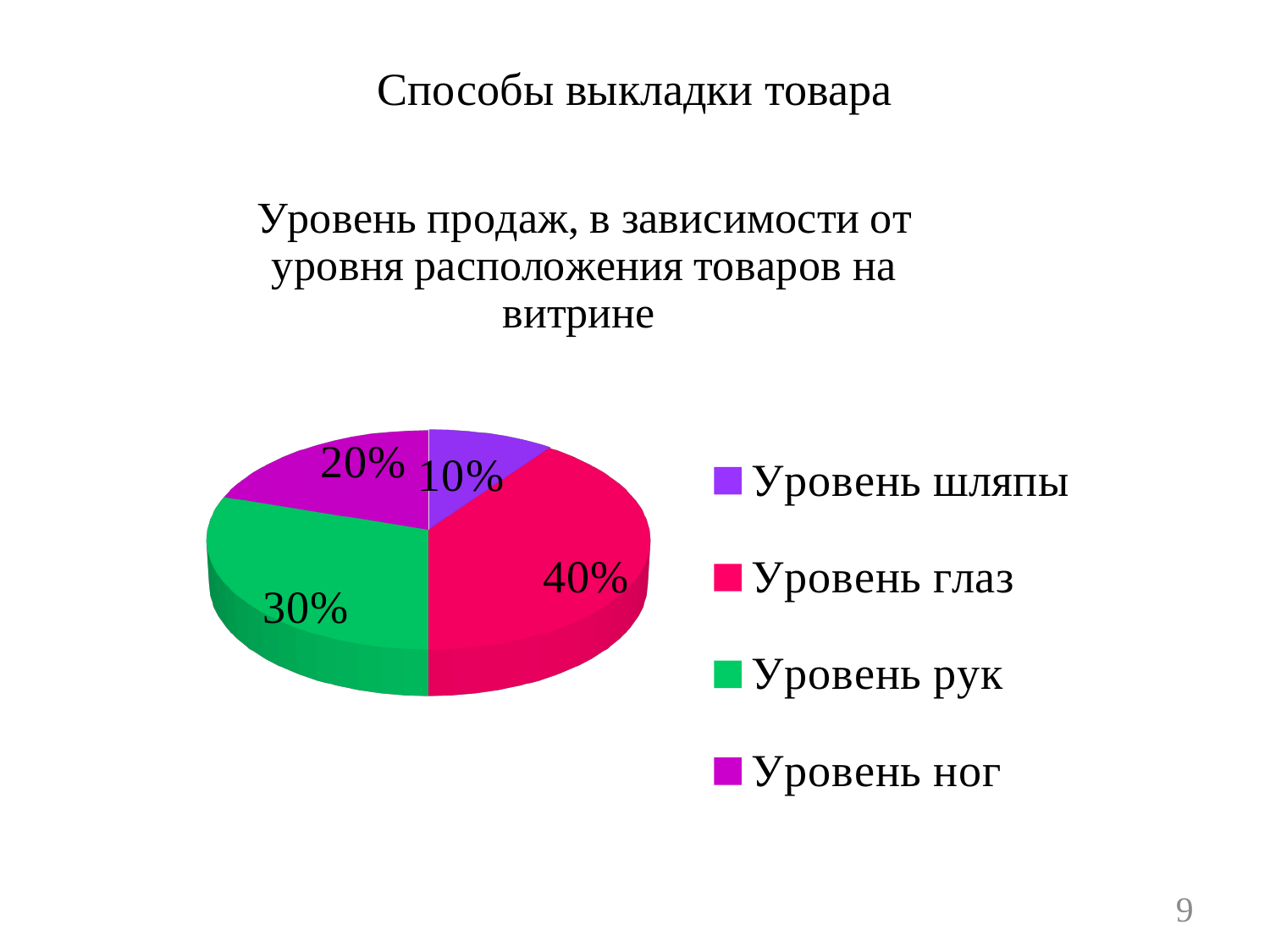
Which is larger, the value for Уровень ног or the value for Уровень шляпы? Уровень ног What is the value for Уровень шляпы? 10% What is the value for Уровень глаз? 40% What type of chart is shown on the slide? Pie chart What colour is the slice for Уровень рук? Green What is the title of the chart? Уровень продаж, в зависимости от уровня расположения товаров на витрине Which category has the largest share of the pie? Уровень глаз What is the difference between the values for Уровень глаз and Уровень рук? 10% What is the value for Уровень рук? 30% How many categories does the pie chart have? 4 What is the value for Уровень ног? 20% Which category has the smallest share of the pie? Уровень шляпы